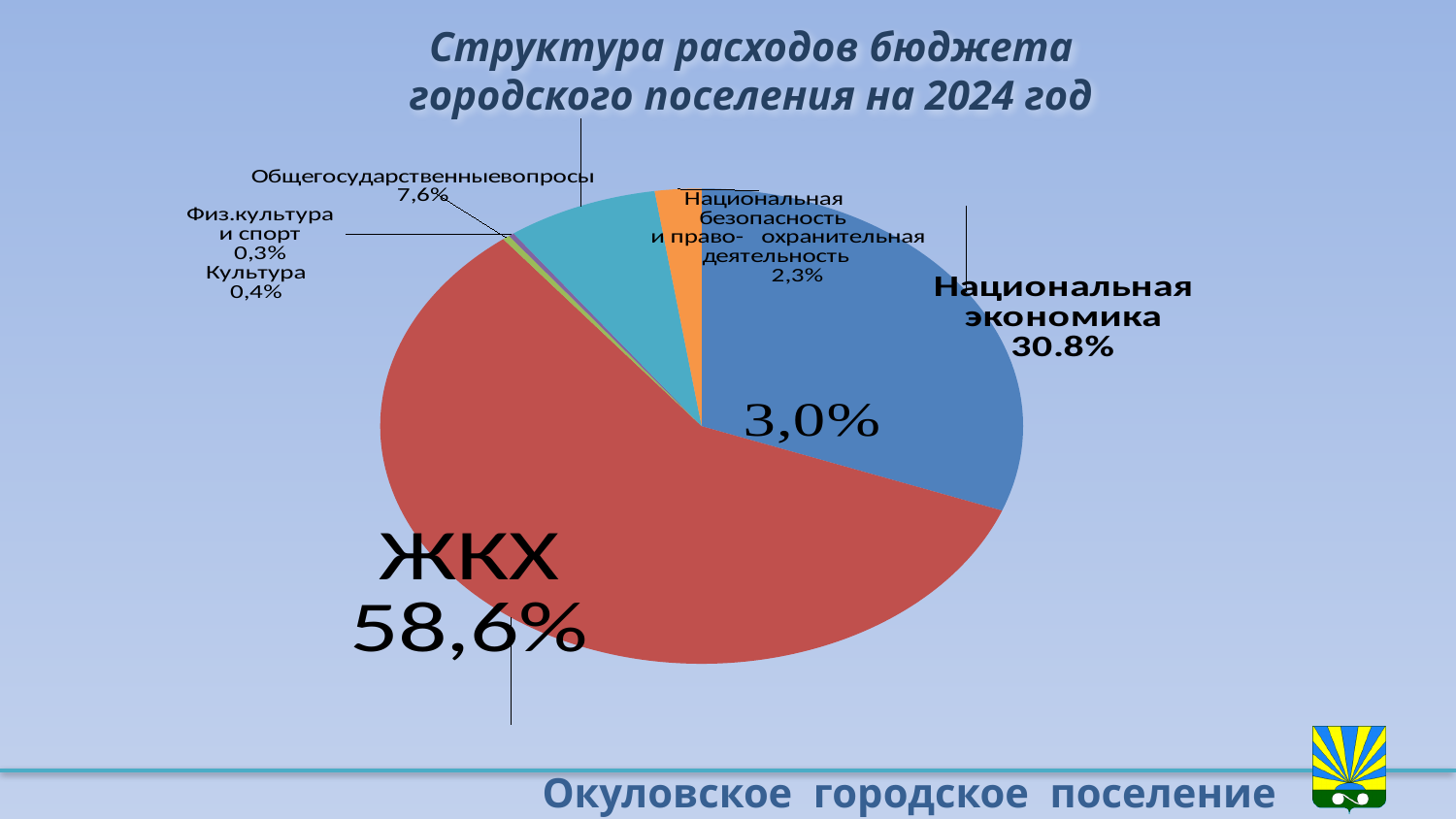
What share of the budget expenditure goes to ЖКХ? 58,6% What is the difference between the shares of Общегосударственные вопросы and Национальная безопасность и правоохранительная деятельность? 5,3% Which expenditure category has the smallest share of the pie? Физ.культура и спорт Which has a larger share: Культура or Физ.культура и спорт? Культура What share is shown for Национальная безопасность и правоохранительная деятельность? 2,3% What share of the budget expenditure goes to Национальная экономика? 30.8% What is the title of the chart? Структура расходов бюджета городского поселения на 2024 год What kind of chart is shown on the slide? Pie chart Which expenditure category has the largest share of the pie? ЖКХ What share is shown for Физ.культура и спорт? 0,3% What share is shown for Общегосударственные вопросы? 7,6% What share is shown for Культура? 0,4%